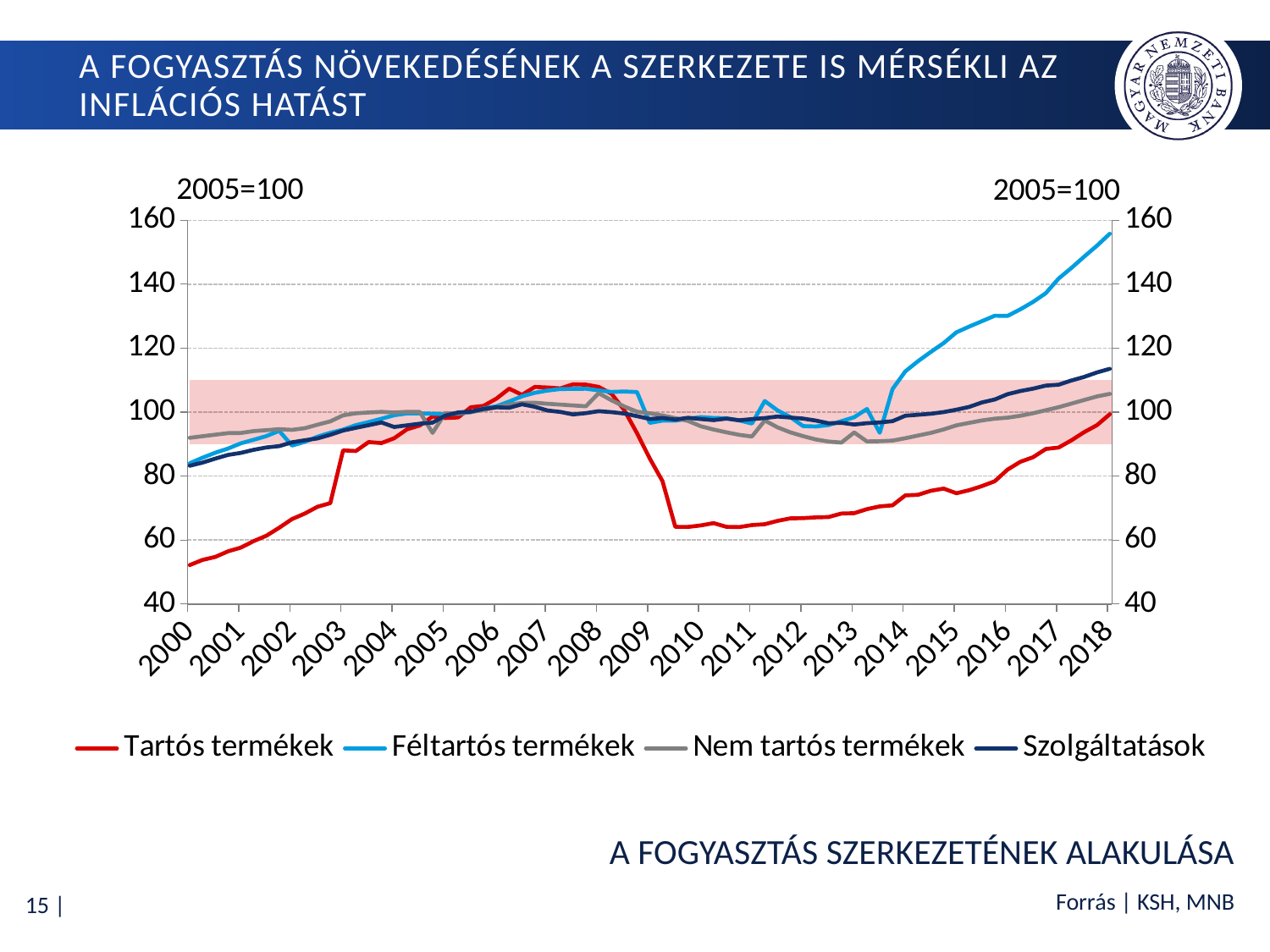
Is the value for Féltartós termékek in 2018 greater or less than 140? greater Is the value for Tartós termékek in 2010 greater or less than 80? less Which series has the lowest value in 2000? Tartós termékek Is the value for Szolgáltatások in 2018 greater or less than 100? greater How many series does the legend list? 4 What is the title of the chart? A FOGYASZTÁS SZERKEZETÉNEK ALAKULÁSA Which series has the highest value in 2018? Féltartós termékek In 2018, which is larger: Féltartós termékek or Tartós termékek? Féltartós termékek How many year labels are shown on the x axis? 19 What kind of chart is shown on the slide? Line chart Does the Féltartós termékek series rise or fall between 2014 and 2018? Rises